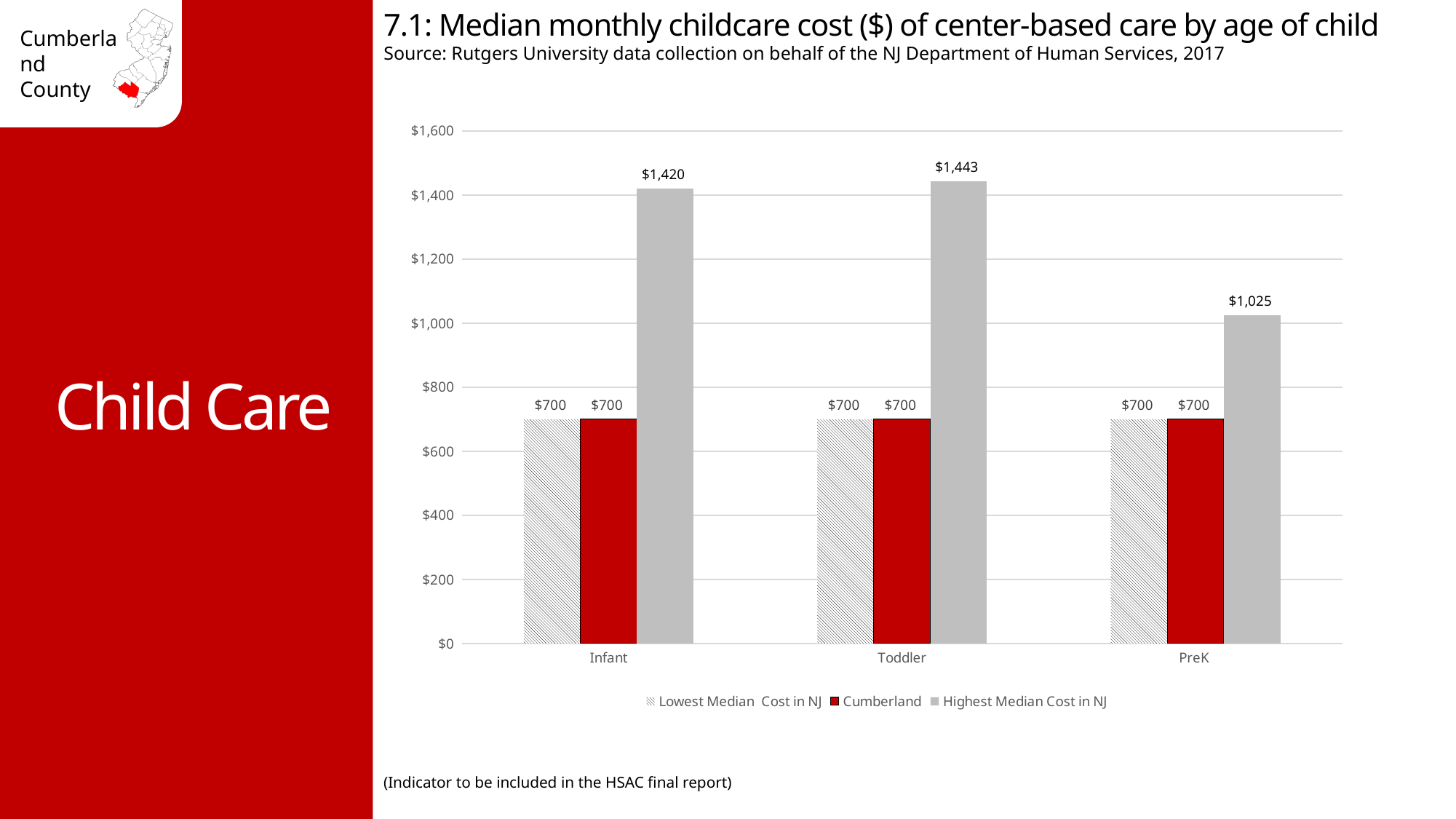
What is the difference between the Highest Median Cost in NJ for Toddler and for PreK? $418 Which age group has the lowest value for the Highest Median Cost in NJ series? PreK What is the Highest Median Cost in NJ for Toddler care? $1,443 What kind of chart is shown on the slide? Bar chart Which age group has the highest value for the Highest Median Cost in NJ series? Toddler What is the Cumberland median monthly cost for Toddler care? $700 How many series does the legend list? 3 What is the Highest Median Cost in NJ for Infant care? $1,420 Is the Highest Median Cost in NJ for PreK greater or less than $1,000? greater What is the difference between the Highest Median Cost in NJ and the Cumberland cost for Infant care? $720 What is the Highest Median Cost in NJ for PreK care? $1,025 What is the Lowest Median Cost in NJ for PreK care? $700